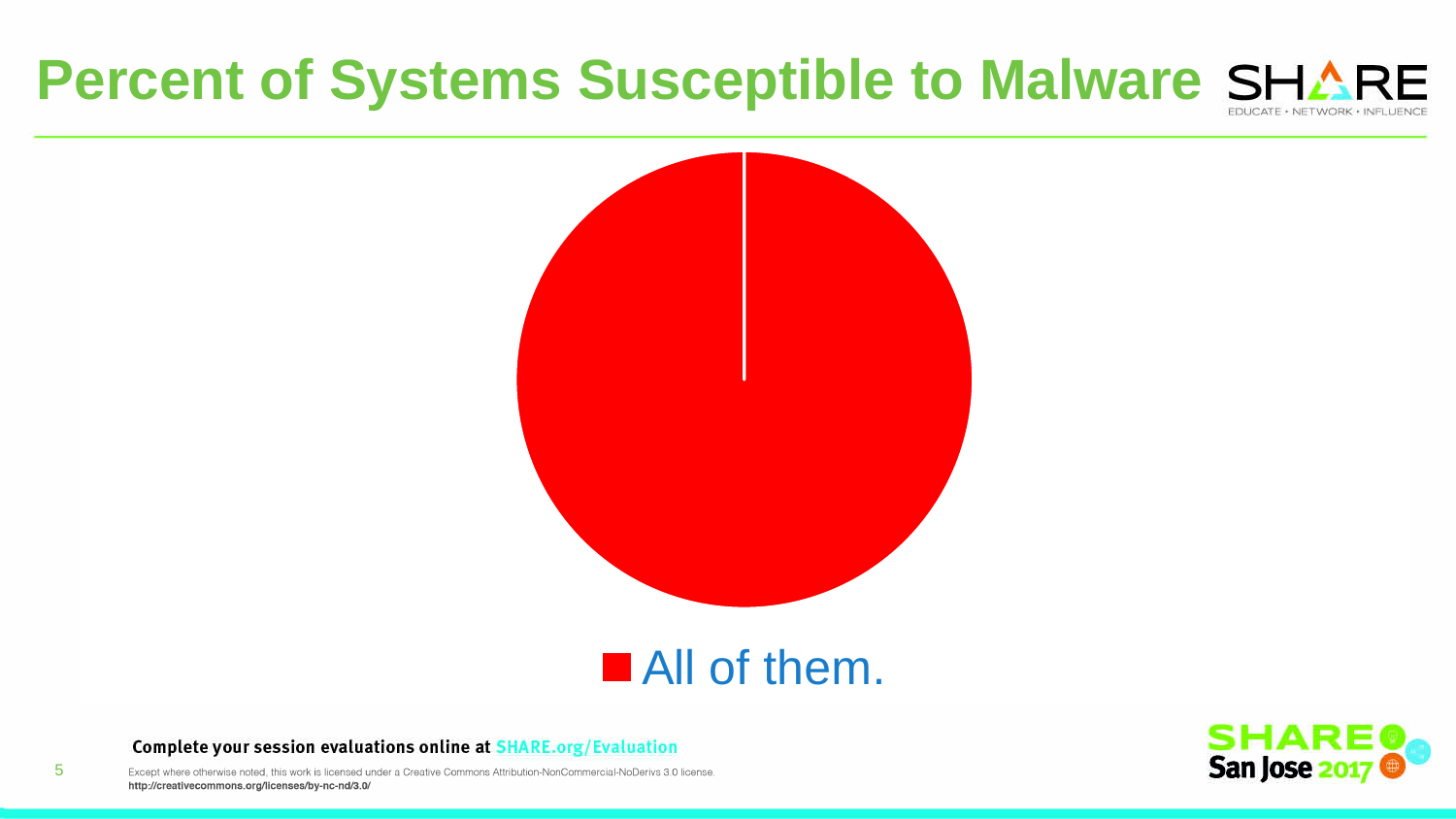
What share of the pie does the slice labelled "All of them." take up? 100% What kind of chart is shown on the slide? pie chart What is the label of the only legend entry in the pie chart? All of them. How many slices does the pie chart have? 1 What is the title of the chart on the slide? Percent of Systems Susceptible to Malware How many entries does the legend of the pie chart list? 1